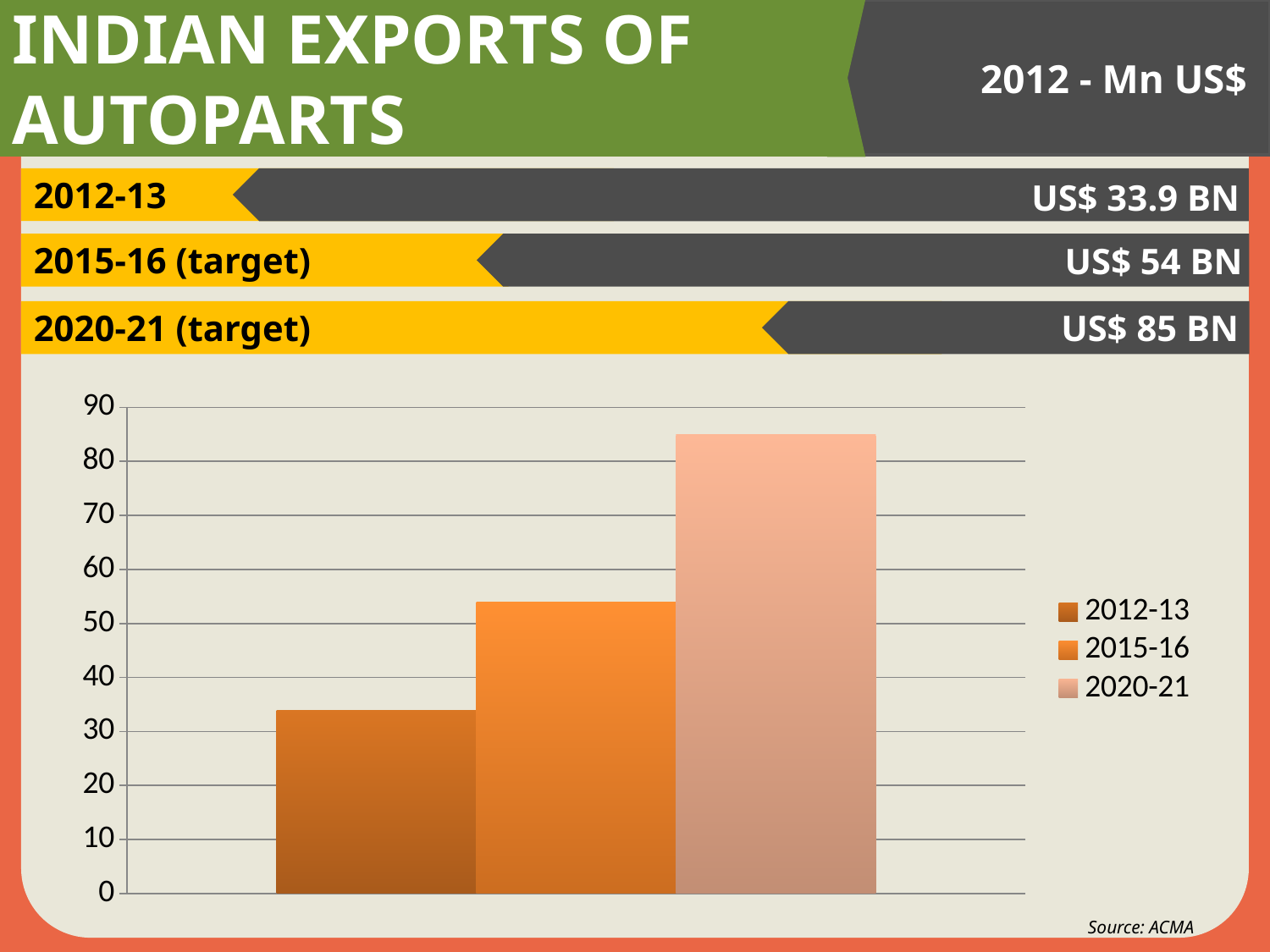
Which period has the tallest bar in the chart? 2020-21 Is the bar for 2020-21 greater or less than 80? greater Is the bar for 2012-13 greater or less than 40? less Is the bar for 2015-16 greater or less than 50? greater What kind of chart is shown on the slide? bar chart How many bars are plotted in the chart? 3 How many entries does the chart legend list? 3 What is the highest value shown on the chart's vertical axis? 90 Do the bar values rise or fall from 2012-13 to 2020-21? rise Which bar is taller, 2015-16 or 2020-21? 2020-21 According to the slide, what is the export value shown for 2015-16 (target)? US$ 54 BN Which period has the shortest bar in the chart? 2012-13